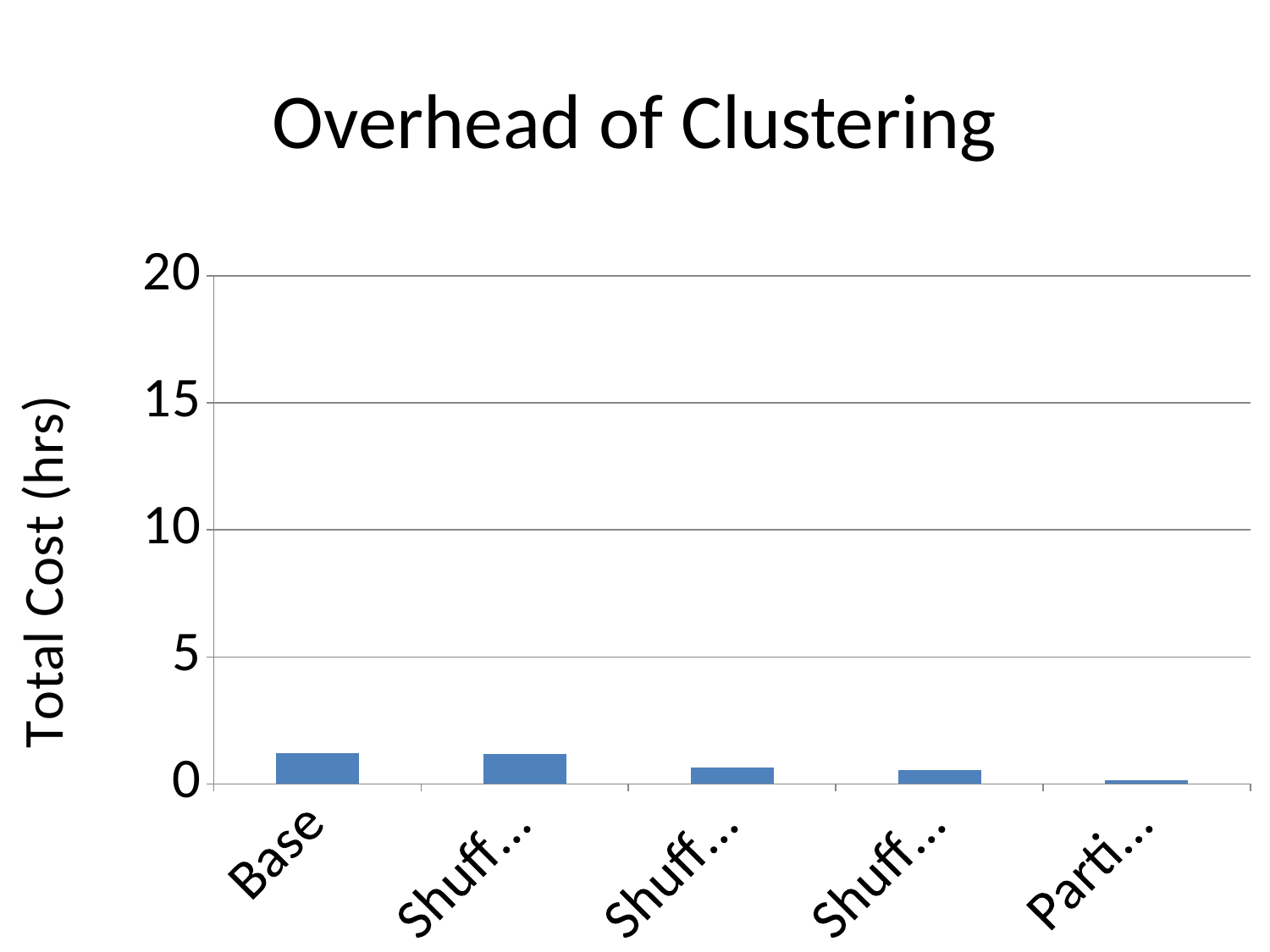
Are all the bars in the chart below 5 hours? yes What is the title of the chart? Overhead of Clustering What is the label on the vertical axis of the chart? Total Cost (hrs) Is the value for Base greater or less than 5? less Do the bar values generally rise or fall from left to right across the chart? fall Is the value for Base greater or less than 10? less Which is larger, the value for Base or the value of the rightmost bar? Base What is the highest value shown on the vertical axis? 20 How many bars are plotted in the chart? 5 What kind of chart is shown on the slide? bar chart